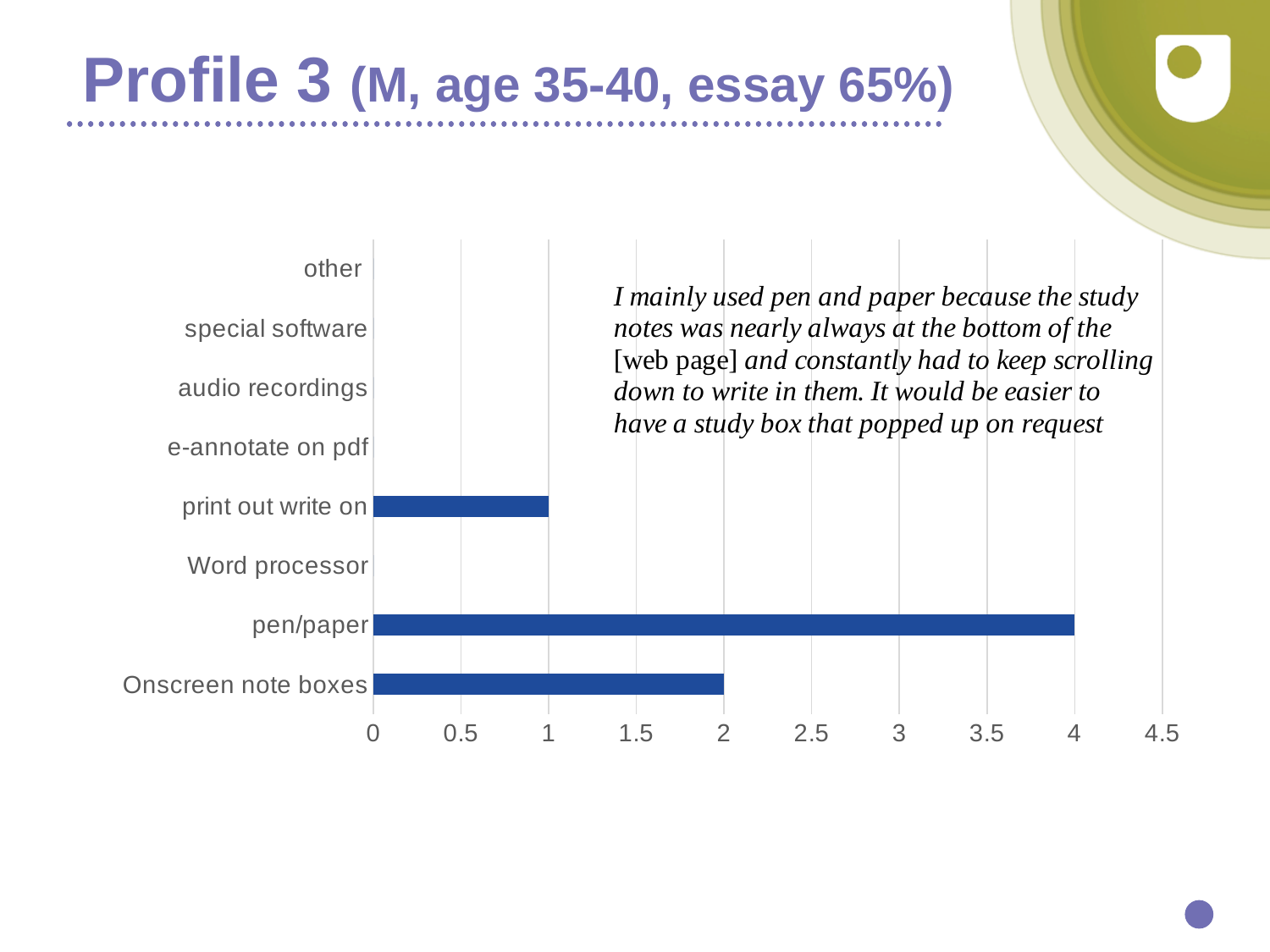
What is the value for pen/paper? 4 What is the value for print out write on? 1 What kind of chart is shown on the slide? bar chart How many categories are listed on the vertical axis of the chart? 8 What is the highest value shown on the horizontal axis? 4.5 Is the value for pen/paper greater or less than 3? greater How many categories have a visible bar in the chart? 3 What is the difference between the values for pen/paper and Onscreen note boxes? 2 What is the difference between the values for Onscreen note boxes and print out write on? 1 Which category has the highest value? pen/paper What is the value for Onscreen note boxes? 2 Which is larger, the value for Onscreen note boxes or the value for print out write on? Onscreen note boxes